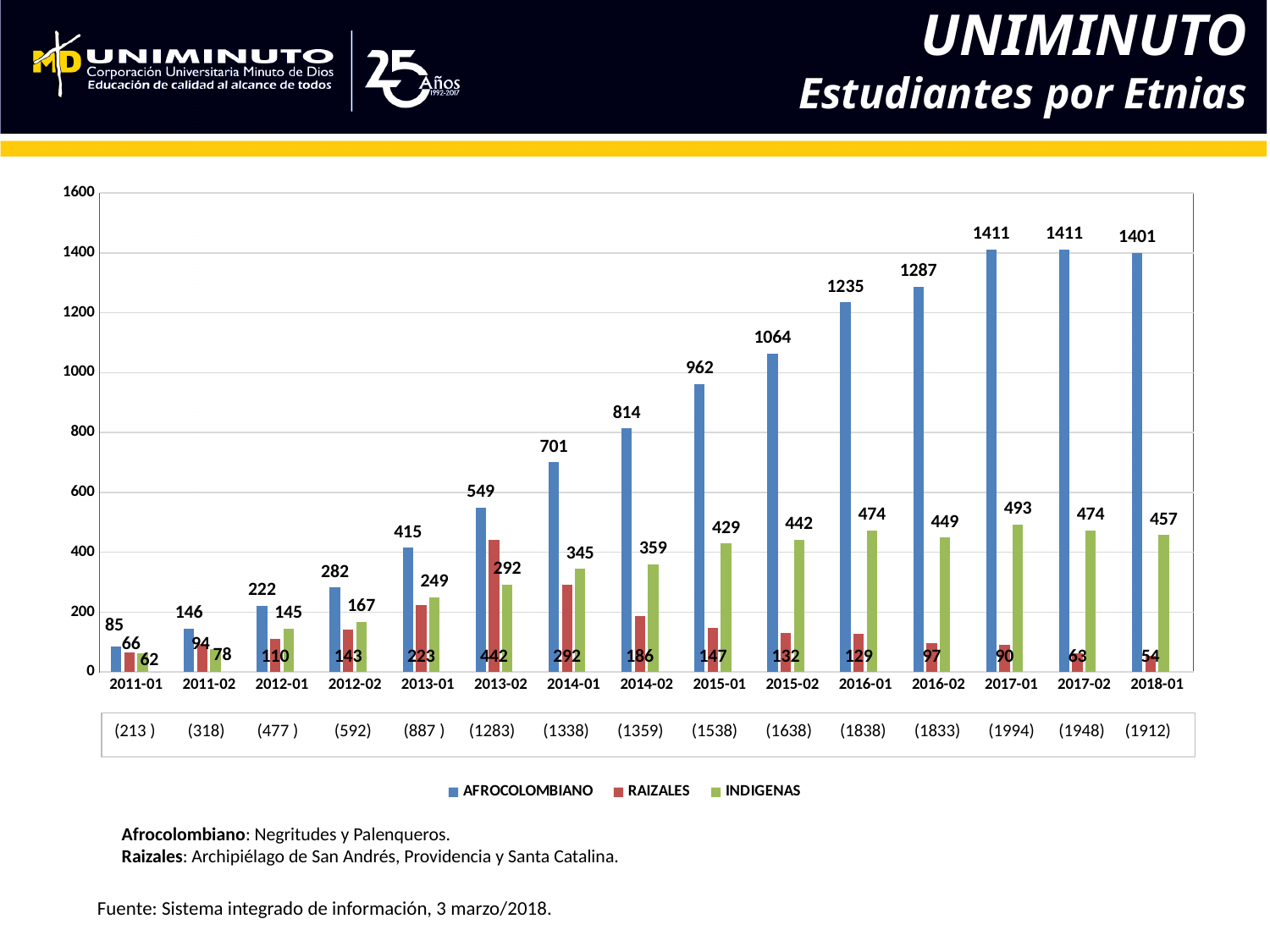
What kind of chart is shown on the slide? Bar chart How many periods are shown on the x axis? 15 How many series does the legend list? 3 What is the value for AFROCOLOMBIANO in 2015-01? 962 In which period is the RAIZALES value highest? 2013-02 What is the difference between the AFROCOLOMBIANO values in 2018-01 and 2011-01? 1316 In 2014-01, which is larger: RAIZALES or INDIGENAS? INDIGENAS What is the value for INDIGENAS in 2017-01? 493 What is the total of the three series in 2011-02? 318 In which period is the RAIZALES value lowest? 2018-01 In which period is the INDIGENAS value highest? 2017-01 What is the value for RAIZALES in 2013-02? 442